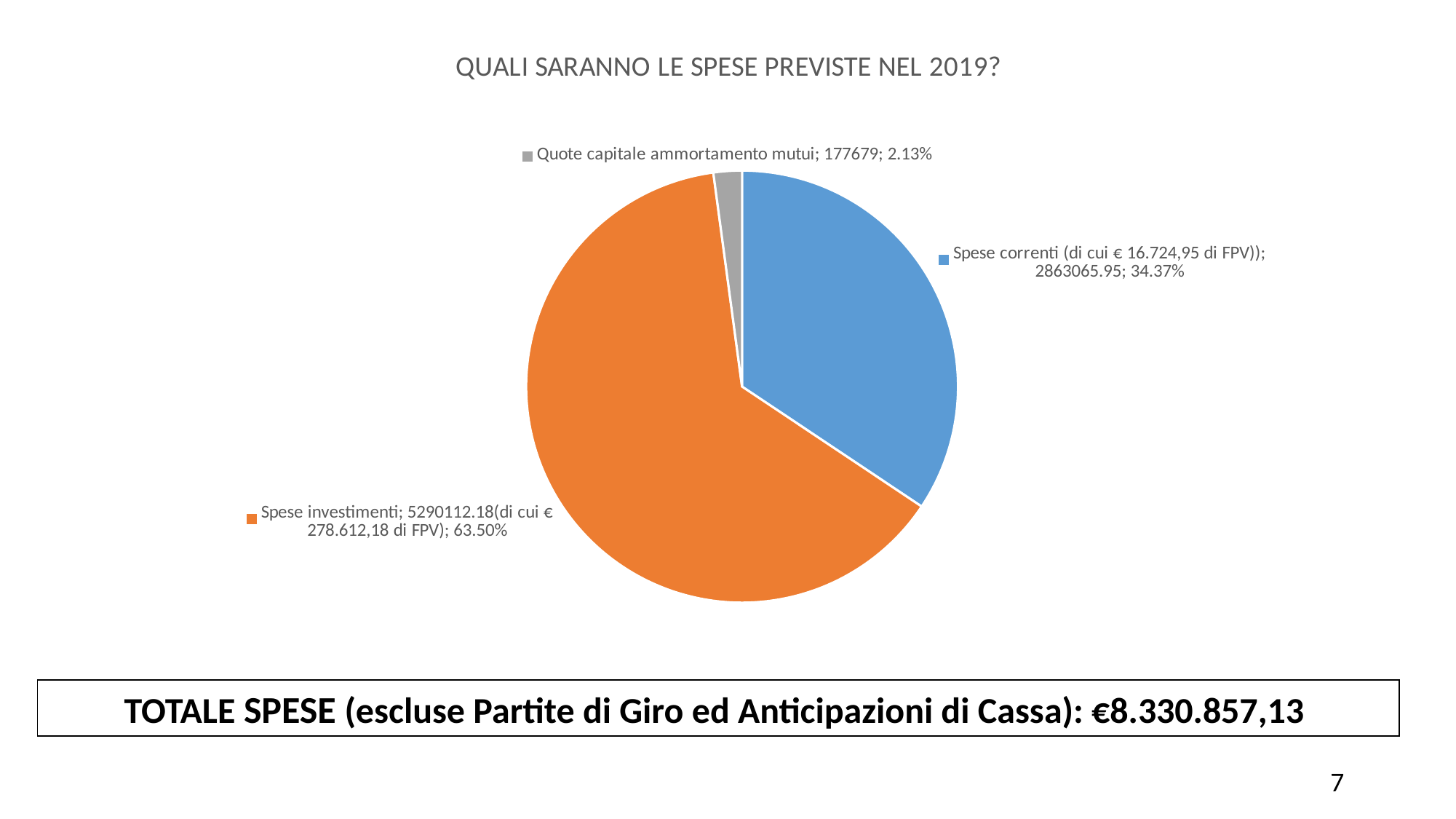
What is the value shown for Quote capitale ammortamento mutui? 177679 Which is larger, Spese correnti or Spese investimenti? Spese investimenti What kind of chart is shown on the slide? pie chart What percentage share does Spese correnti have? 34.37% How many slices does the pie chart have? 3 What percentage share does Spese investimenti have? 63.50% What is the title of the chart? QUALI SARANNO LE SPESE PREVISTE NEL 2019? What percentage share does Quote capitale ammortamento mutui have? 2.13% What is the value shown for Spese correnti? 2863065.95 What is the value shown for Spese investimenti? 5290112.18 Which category has the smallest slice of the pie? Quote capitale ammortamento mutui Which category has the largest slice of the pie? Spese investimenti